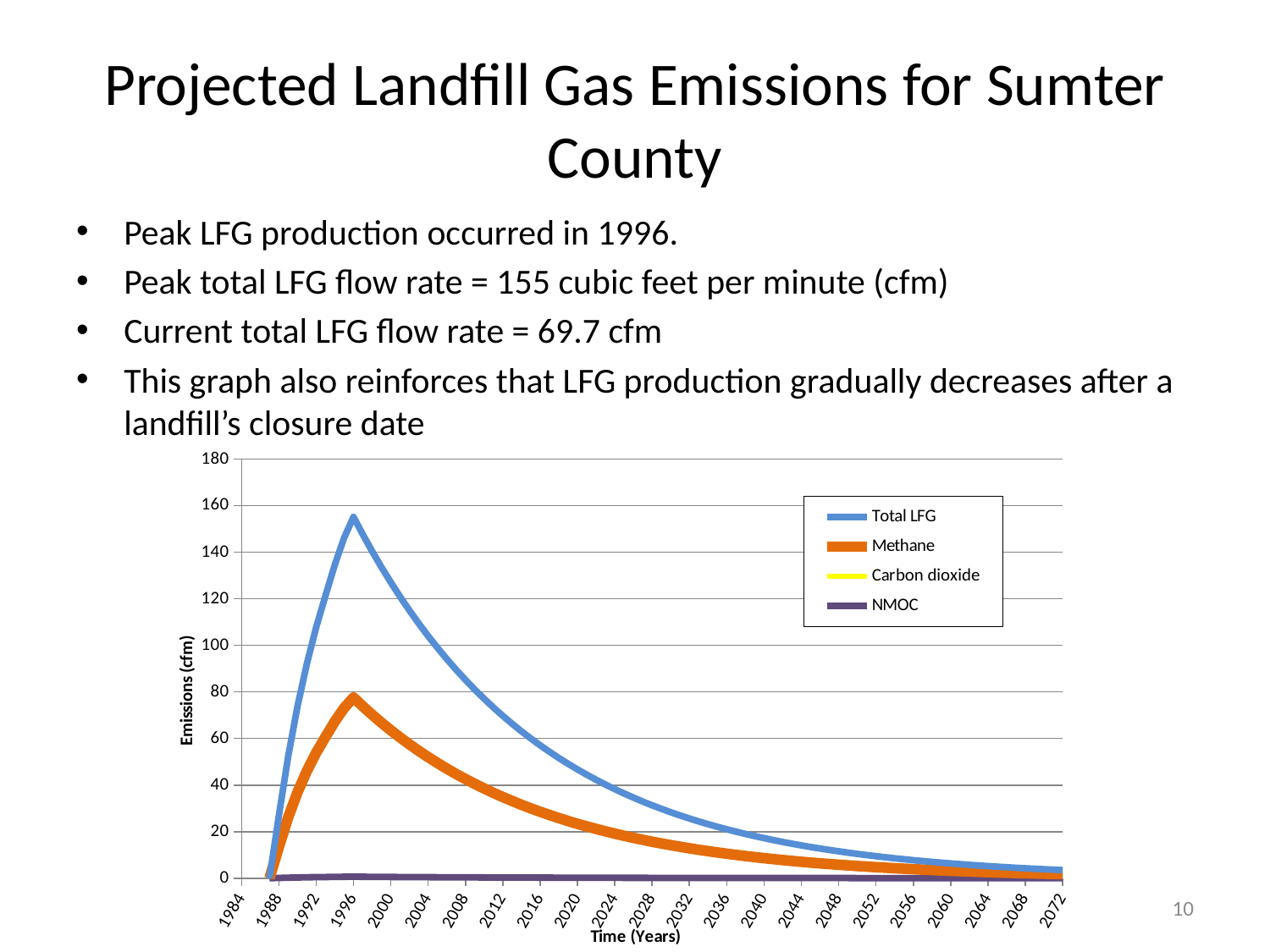
Is the peak value of Total LFG greater or less than 140? greater What type of chart is shown on the slide? Line chart Is the Total LFG value in 2040 greater or less than 40? less In which year does the Total LFG line reach its peak? 1996 In 2000, which is larger: Total LFG or Methane? Total LFG Is the peak value of Methane greater or less than 60? greater How many series does the chart legend list? 4 Which series are listed in the chart legend? Total LFG, Methane, Carbon dioxide, NMOC What is the label of the chart's vertical axis? Emissions (cfm) How does the Total LFG line change from 1996 to 2072? It falls Which series reaches the highest value on the chart? Total LFG Which series stays lowest across the chart? NMOC